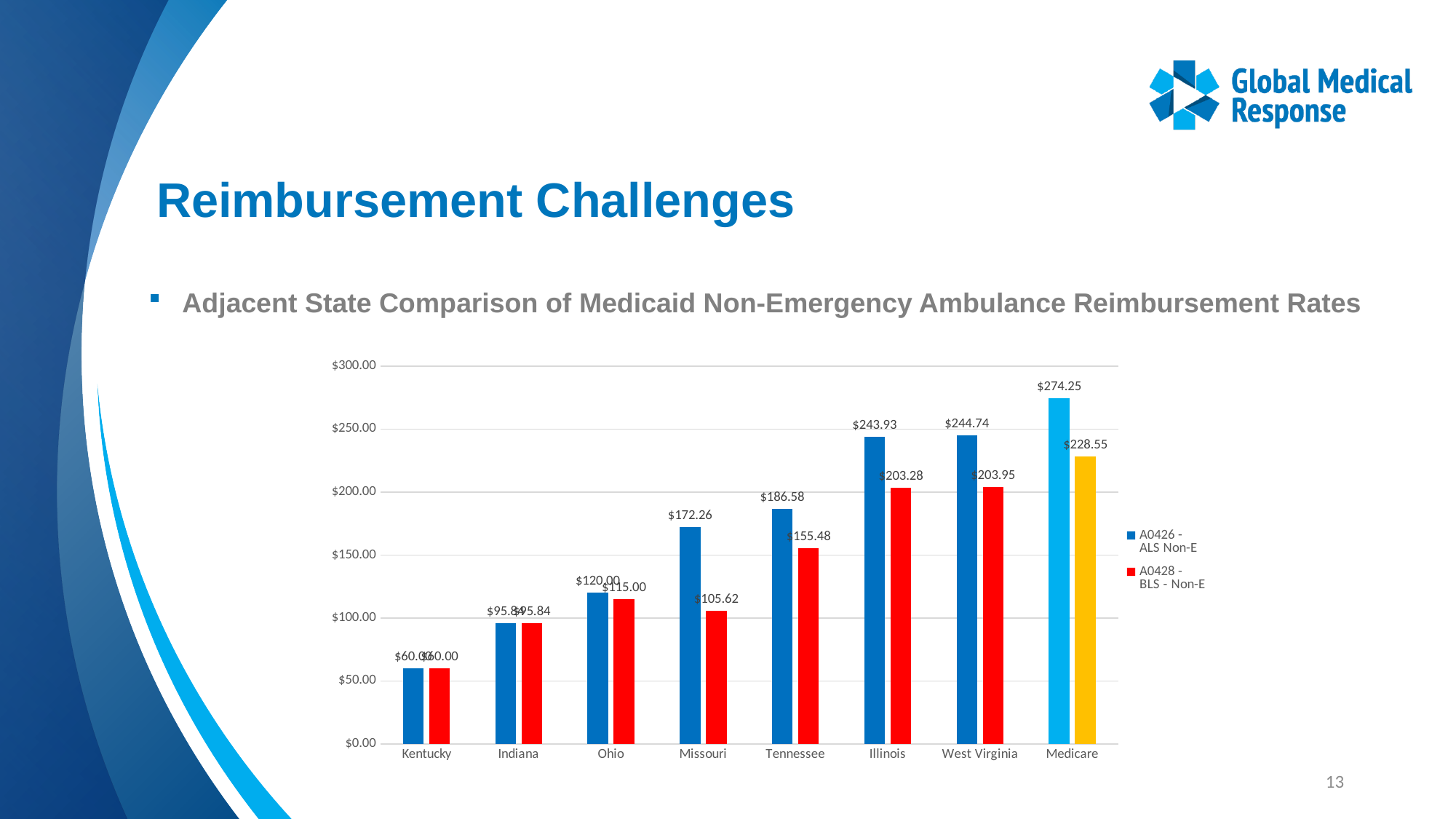
What is the difference between the A0426 - ALS Non-E and A0428 - BLS - Non-E values for Illinois? $40.65 What kind of chart is shown on the slide? bar chart Which category has the lowest A0426 - ALS Non-E value? Kentucky Which category has the highest A0426 - ALS Non-E value? Medicare What is the A0426 - ALS Non-E value for Tennessee? $186.58 Which is larger, the A0426 - ALS Non-E value for Ohio or for Missouri? Missouri How many categories are shown along the x axis of the chart? 8 Do the A0426 - ALS Non-E values generally rise or fall from Kentucky to Medicare along the x axis? rise What is the A0428 - BLS - Non-E value for Missouri? $105.62 How many series does the chart's legend list? 2 Is the A0428 - BLS - Non-E value for West Virginia greater or less than $200.00? greater What is the A0426 - ALS Non-E value for Medicare? $274.25